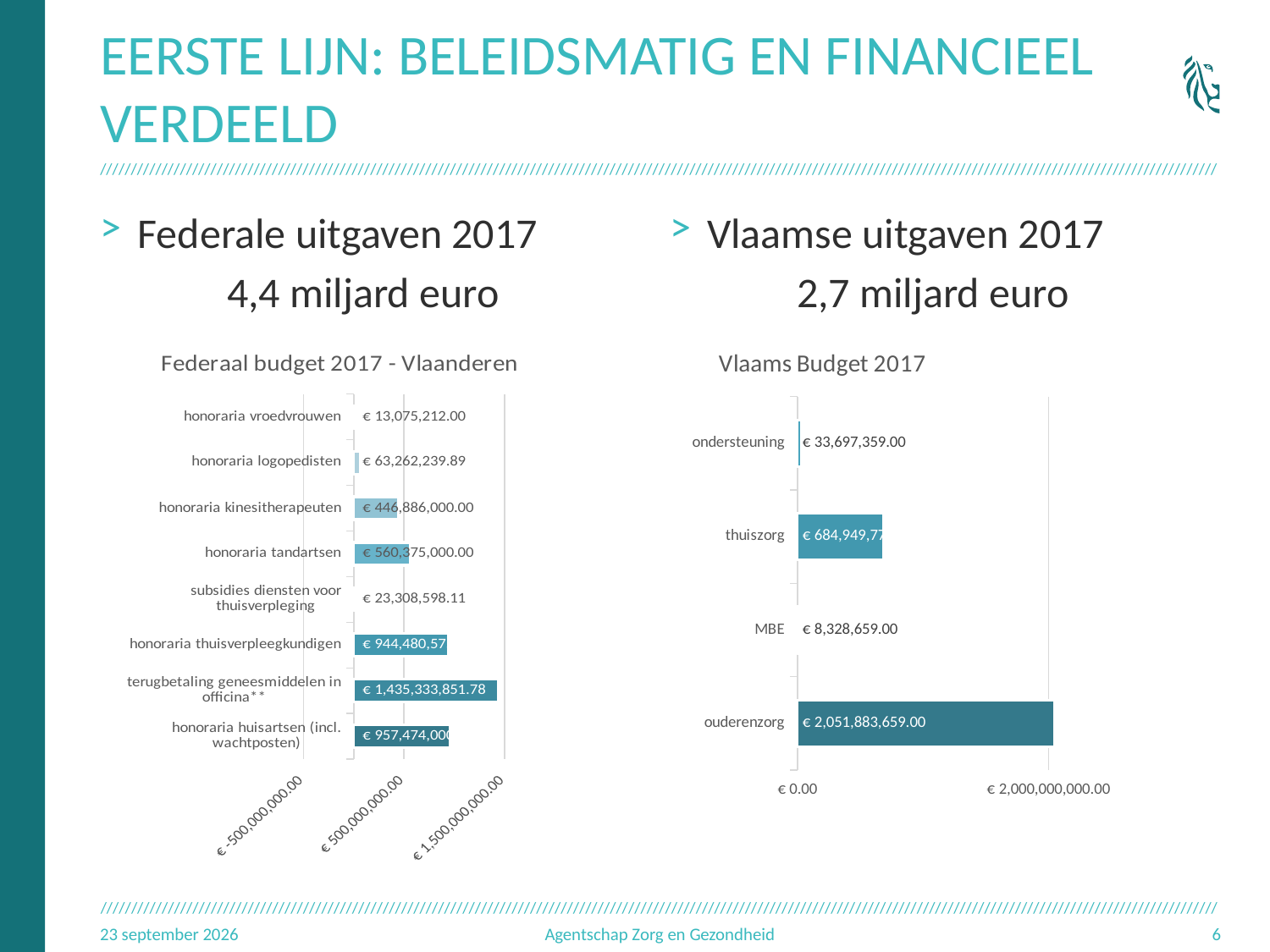
In the chart titled 'Federaal budget 2017 - Vlaanderen', how many categories are shown? 8 In the chart titled 'Federaal budget 2017 - Vlaanderen', what is the value for honoraria tandartsen? € 560,375,000.00 In the chart titled 'Federaal budget 2017 - Vlaanderen', is the value for honoraria huisartsen (incl. wachtposten) greater or less than € 500,000,000.00? greater In the chart titled 'Federaal budget 2017 - Vlaanderen', which category has the lowest value? honoraria vroedvrouwen In the chart titled 'Vlaams Budget 2017', which category has the lowest value? MBE In the chart titled 'Federaal budget 2017 - Vlaanderen', which category has the highest value? terugbetaling geneesmiddelen in officina** What kind of chart is the chart titled 'Vlaams Budget 2017'? bar chart In the chart titled 'Vlaams Budget 2017', what is the value for ouderenzorg? € 2,051,883,659.00 In the chart titled 'Vlaams Budget 2017', is the value for thuiszorg greater or less than € 2,000,000,000.00? less In the chart titled 'Federaal budget 2017 - Vlaanderen', what is the value for terugbetaling geneesmiddelen in officina**? € 1,435,333,851.78 In the chart titled 'Federaal budget 2017 - Vlaanderen', what is the difference between honoraria tandartsen and honoraria kinesitherapeuten? € 113,489,000.00 In the chart titled 'Federaal budget 2017 - Vlaanderen', what is the value for honoraria kinesitherapeuten? € 446,886,000.00